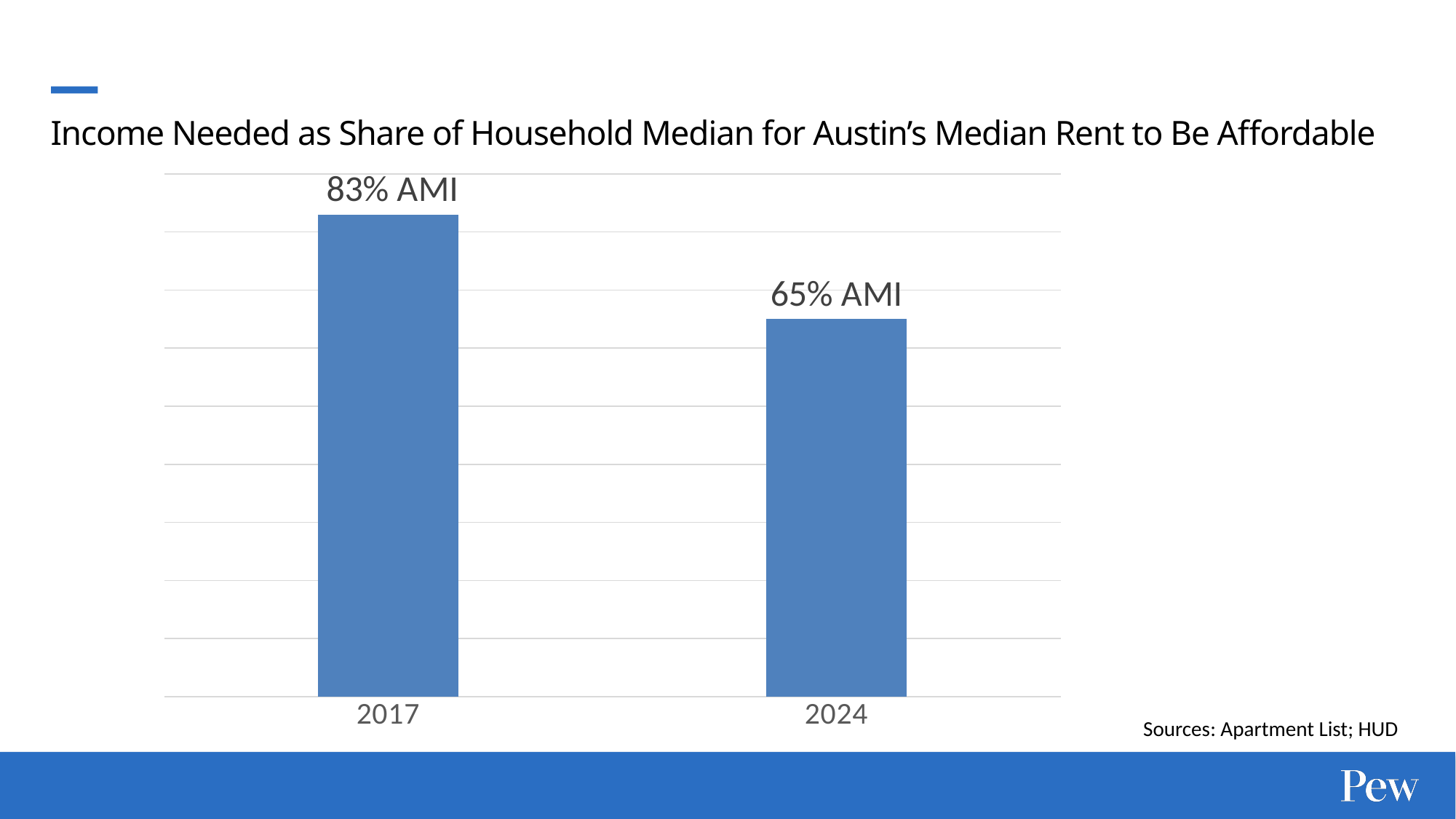
What is the value shown for 2024? 65% AMI Which year has the lower value? 2024 What kind of chart is shown on the slide? bar chart What is the title of the chart? Income Needed as Share of Household Median for Austin's Median Rent to Be Affordable What is the difference in percentage points between the 2017 and 2024 values? 18 percentage points What sources are cited for the chart? Apartment List; HUD What is the value shown for 2017? 83% AMI Which year has the higher value? 2017 Do the values rise or fall from 2017 to 2024? fall Is the value for 2024 larger or smaller than the value for 2017? smaller How many bars are plotted in the chart? 2